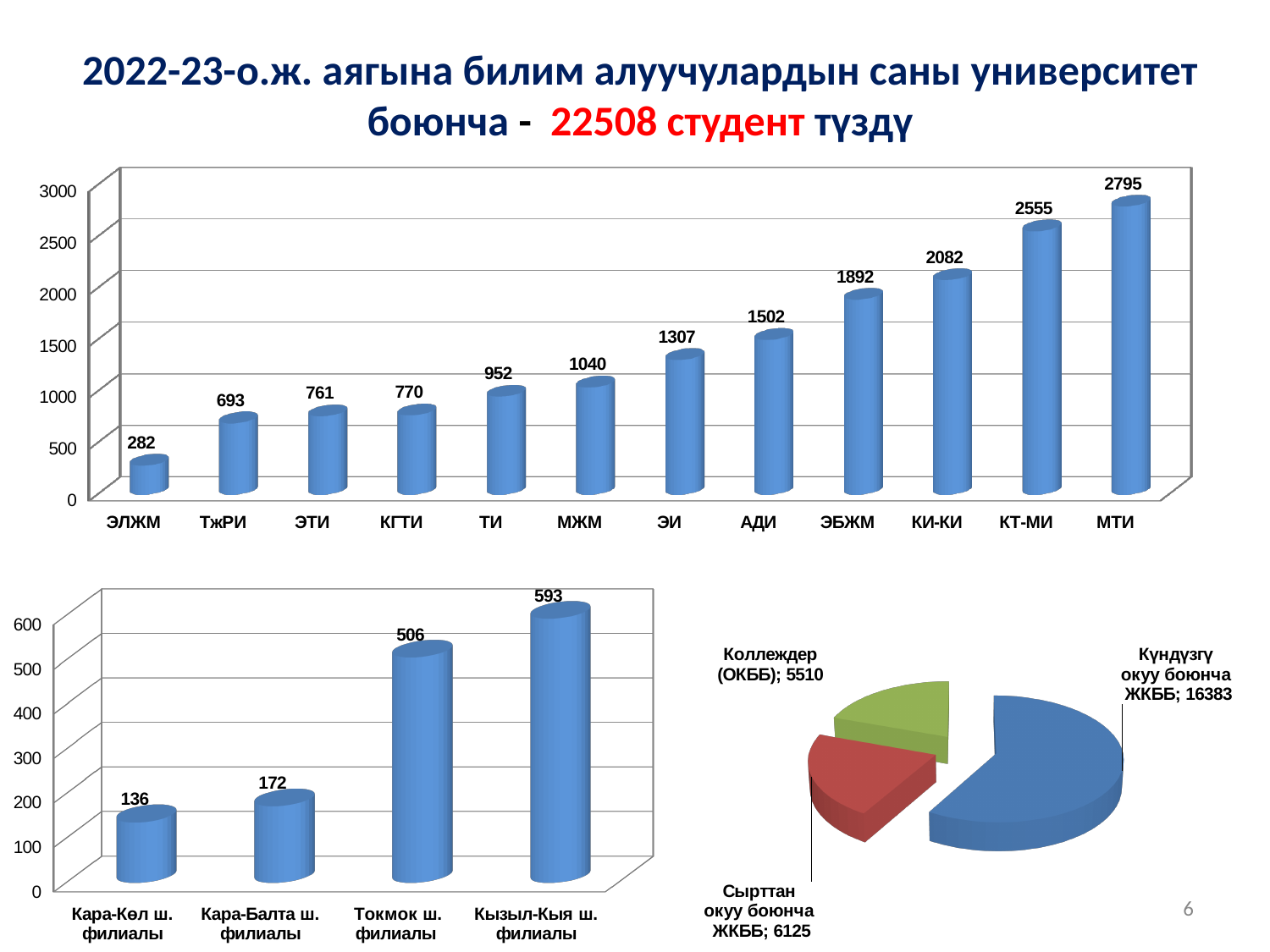
In the top bar chart, which is larger, the value for КИ-КИ or the value for ЭБЖМ? КИ-КИ In the bottom-right pie chart, what is the value for Сырттан окуу боюнча ЖКББ? 6125 What kind of chart is the bottom-right chart? pie chart In the bottom-left bar chart, which category has the highest value? Кызыл-Кыя ш. филиалы How many categories are shown in the top bar chart? 12 In the top bar chart, what is the difference between the values for МТИ and ЭЛЖМ? 2513 In the top bar chart, which category has the lowest value? ЭЛЖМ In the bottom-left bar chart, what is the value for Токмок ш. филиалы? 506 In the bottom-left bar chart, what is the difference between the values for Кызыл-Кыя ш. филиалы and Кара-Көл ш. филиалы? 457 In the top bar chart, what is the value for МТИ? 2795 In the top bar chart, what is the value for ЭИ? 1307 In the top bar chart, do the values rise or fall from left to right along the x axis? rise